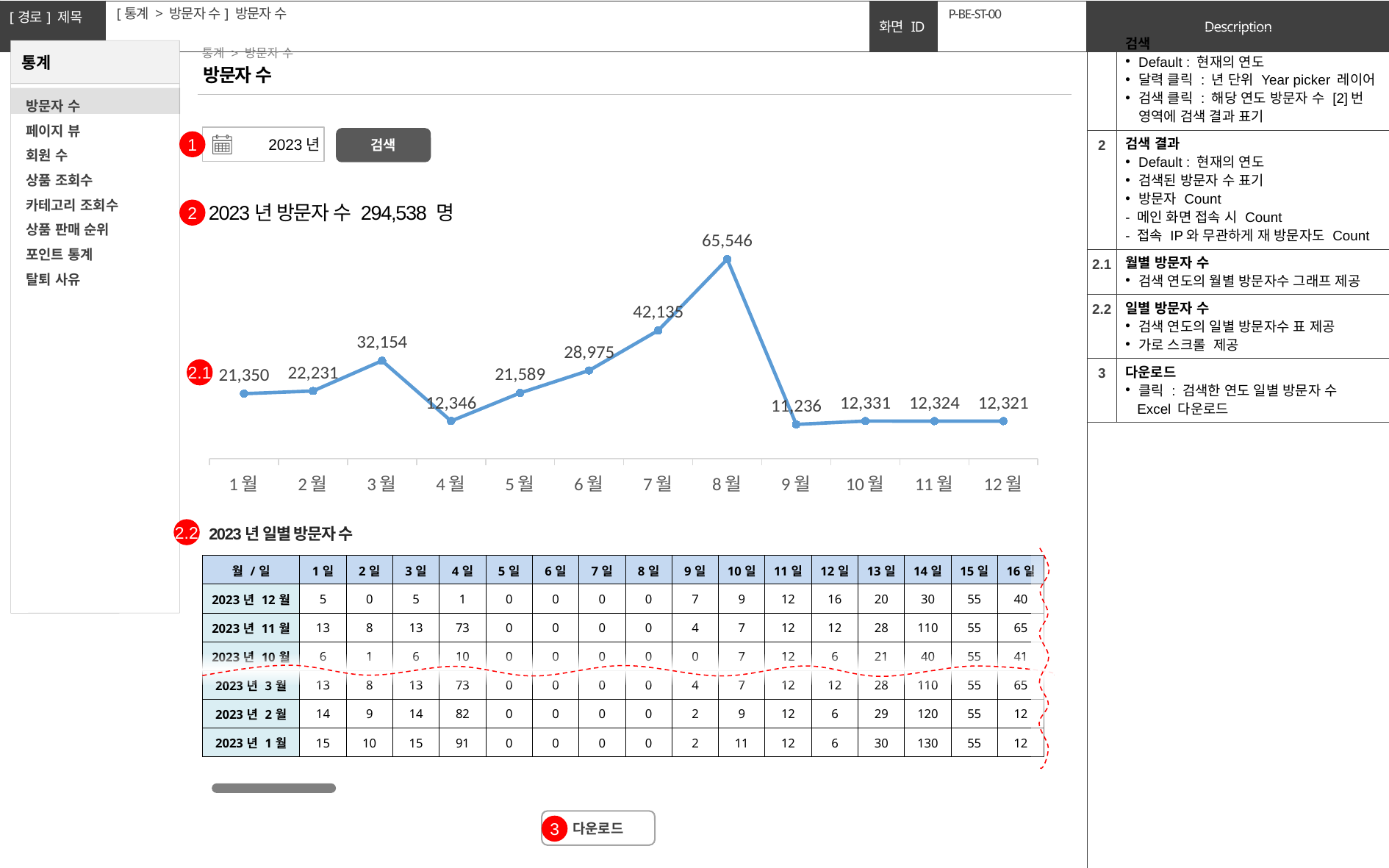
What total visitor count for 2023 is shown in the heading above the line chart? 294,538 명 Which month has the lowest visitor count in the line chart? 9월 What is the difference between the visitor counts for 3월 and 4월? 19,808 What is the visitor count for 8월 in the line chart? 65,546 How many months are plotted on the x axis of the line chart? 12 What is the difference between the visitor counts for 8월 and 7월? 23,411 What is the visitor count for 3월 in the line chart? 32,154 Which month has a larger visitor count, 6월 or 5월? 6월 What kind of chart is used to show the monthly visitor counts? line chart Which month has the highest visitor count in the line chart? 8월 Do the visitor counts rise or fall from 4월 to 8월? rise What is the visitor count for 9월 in the line chart? 11,236